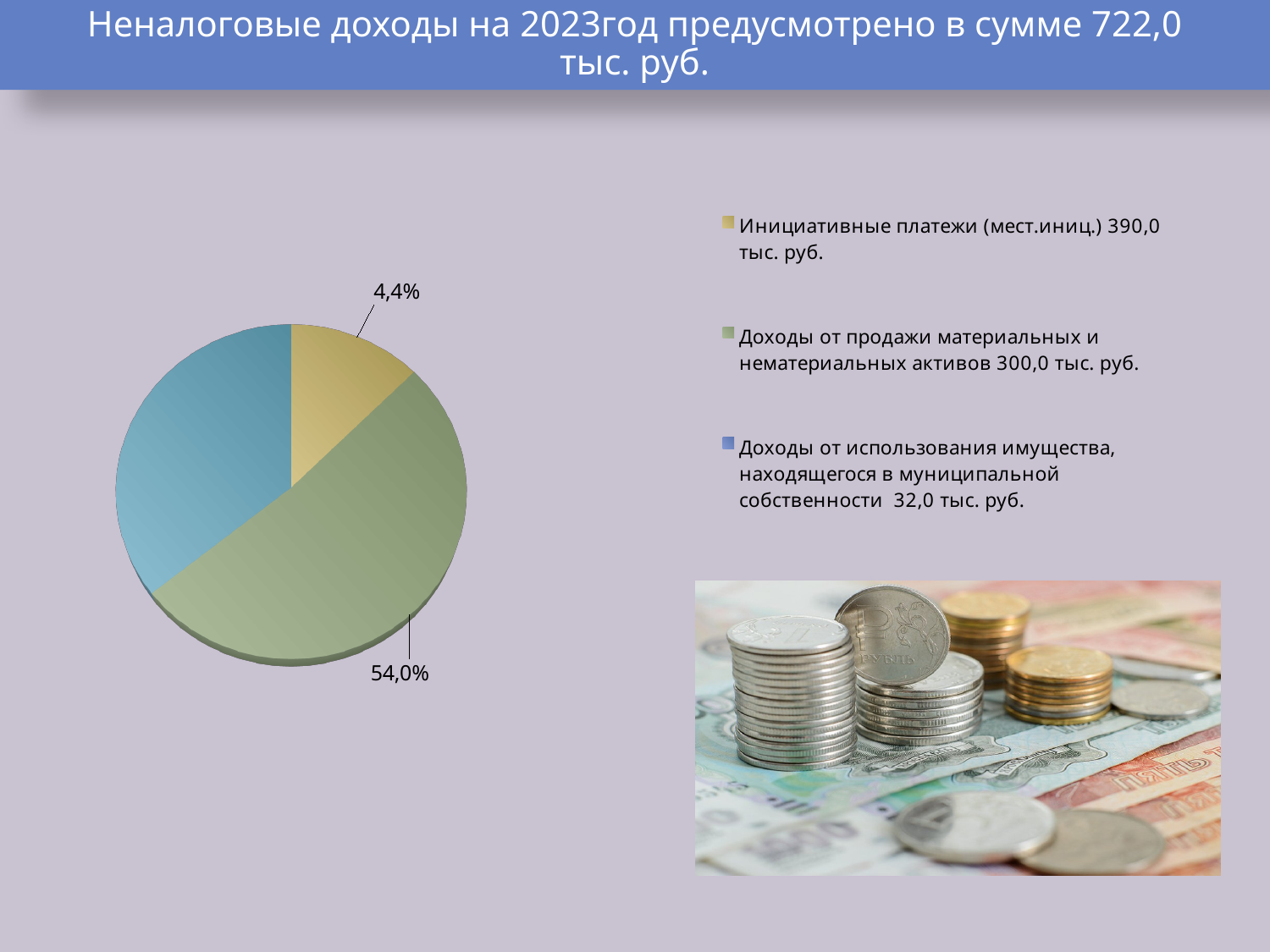
What percentage label is printed at the bottom of the pie chart? 54,0% What total sum of non-tax revenues for 2023 is stated in the slide title? 722,0 тыс. руб. According to the legend, what amount is given for Доходы от продажи материальных и нематериальных активов? 300,0 тыс. руб. What type of chart is shown on the slide? pie chart Which legend entry has the largest amount? Инициативные платежи (мест.иниц.) According to the legend, what amount is given for Инициативные платежи (мест.иниц.)? 390,0 тыс. руб. Which is larger: the amount for Доходы от продажи материальных и нематериальных активов or for Доходы от использования имущества? Доходы от продажи материальных и нематериальных активов Which legend entry has the smallest amount? Доходы от использования имущества, находящегося в муниципальной собственности What is the difference between the amounts for Инициативные платежи and Доходы от продажи материальных и нематериальных активов? 90,0 тыс. руб. How many entries does the legend of the pie chart list? 3 According to the legend, what amount is given for Доходы от использования имущества, находящегося в муниципальной собственности? 32,0 тыс. руб. How many slices does the pie chart have? 3